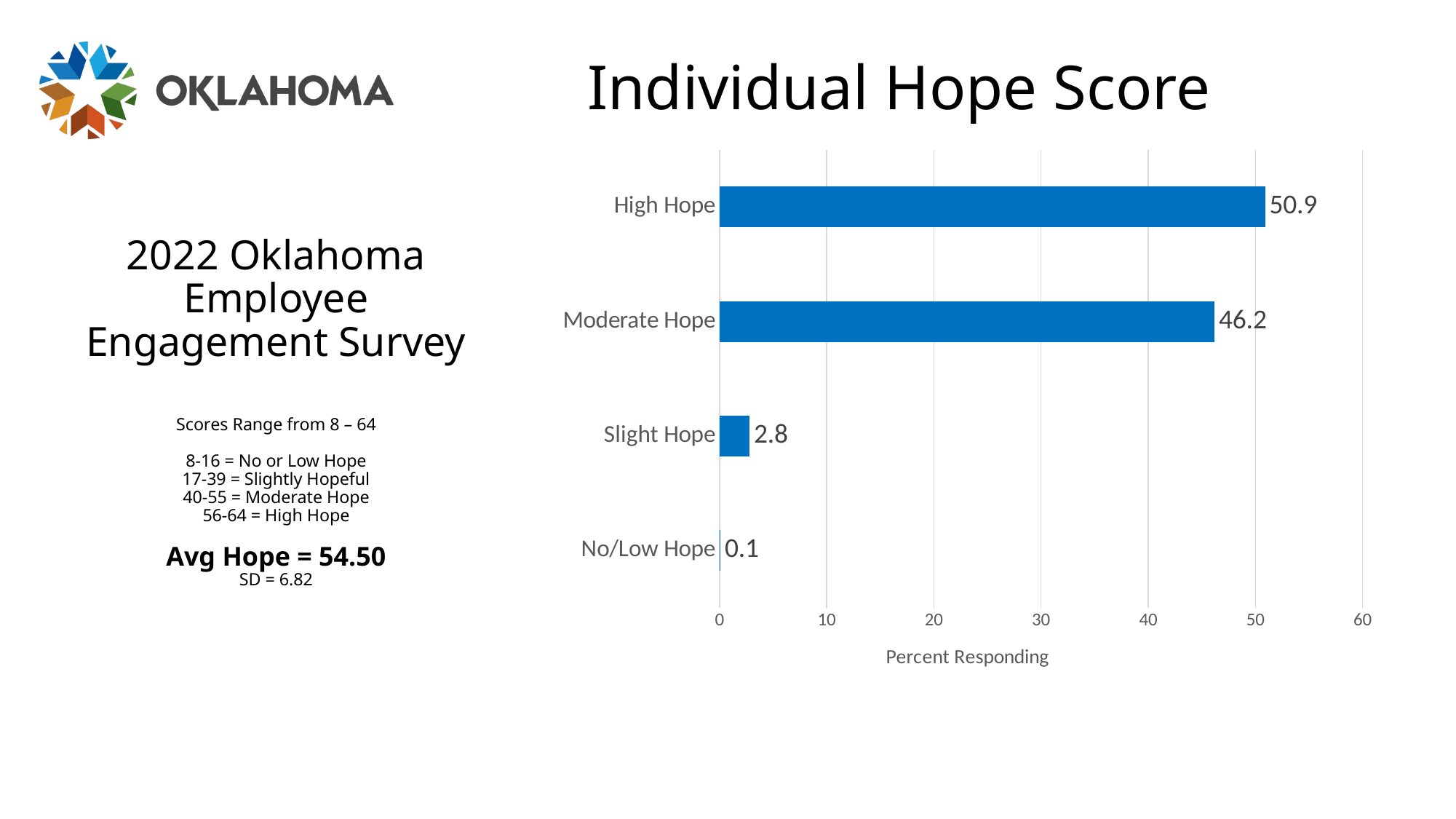
Which category has the highest value? High Hope How many categories are shown in the chart? 4 What is the label of the horizontal axis? Percent Responding What is the difference between the values for High Hope and Moderate Hope? 4.7 What is the value for Slight Hope? 2.8 Which category has the lowest value? No/Low Hope Is the value for Moderate Hope greater or less than 40? greater What is the value for No/Low Hope? 0.1 What is the value for High Hope? 50.9 Which is larger, the value for Slight Hope or the value for No/Low Hope? Slight Hope What is the value for Moderate Hope? 46.2 What kind of chart is shown on the slide? bar chart